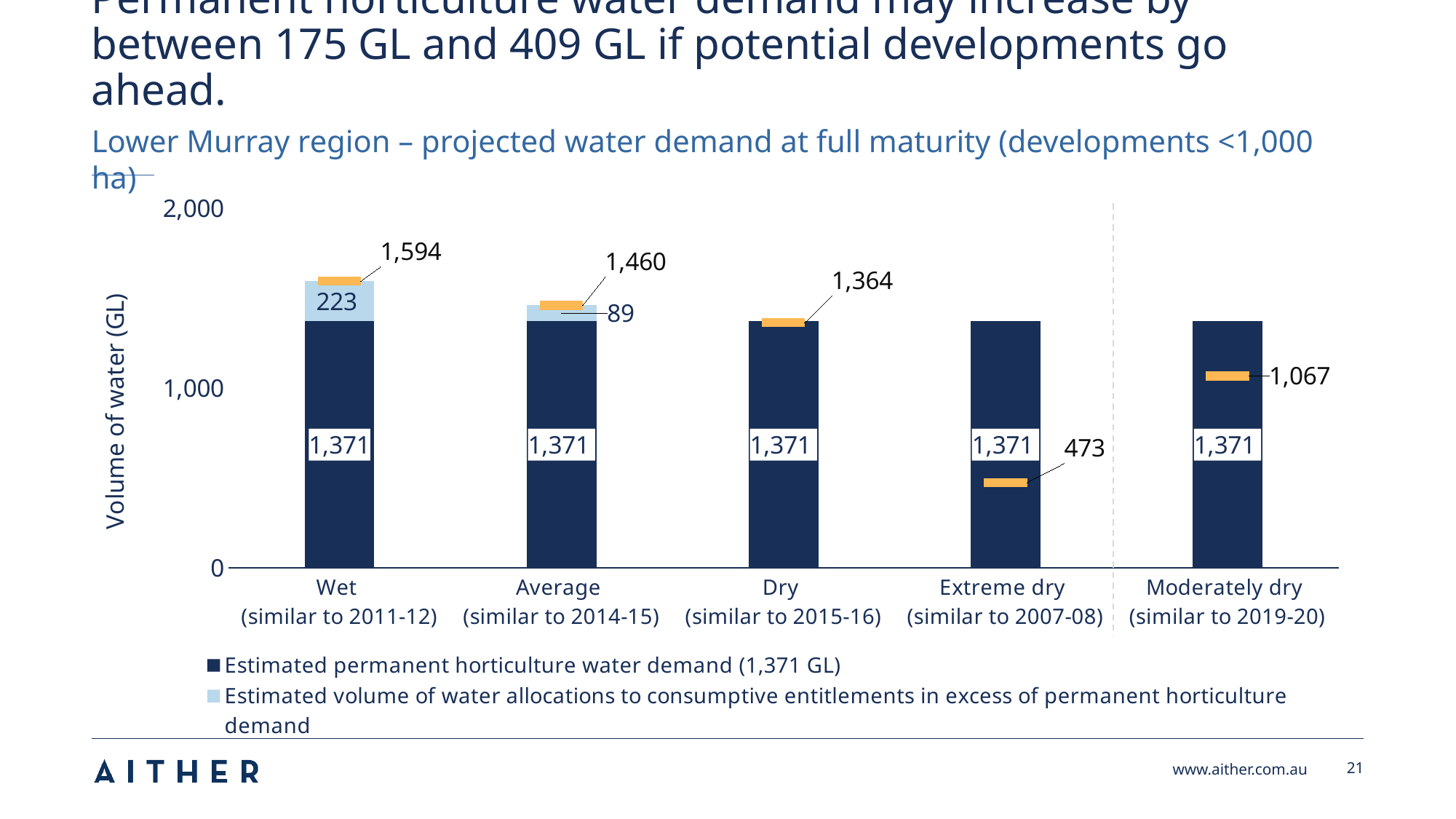
What kind of chart is shown on the slide? bar chart What value is labelled by the orange marker for the Moderately dry scenario? 1,067 What is the estimated volume of water allocations in excess of permanent horticulture demand for the Wet scenario? 223 What value is labelled by the orange marker for the Extreme dry scenario? 473 What is the total height of the stacked bar for the Wet scenario? 1,594 How many scenario categories are shown on the x axis? 5 Which scenario has the lowest orange marker value? Extreme dry What is the estimated volume of water allocations in excess of permanent horticulture demand for the Average scenario? 89 How many series does the legend list? 2 What is the estimated permanent horticulture water demand for the Dry scenario? 1,371 What is the difference between the orange marker values for the Wet and Extreme dry scenarios? 1,121 Is the orange marker value for the Moderately dry scenario greater or less than 1,000? greater